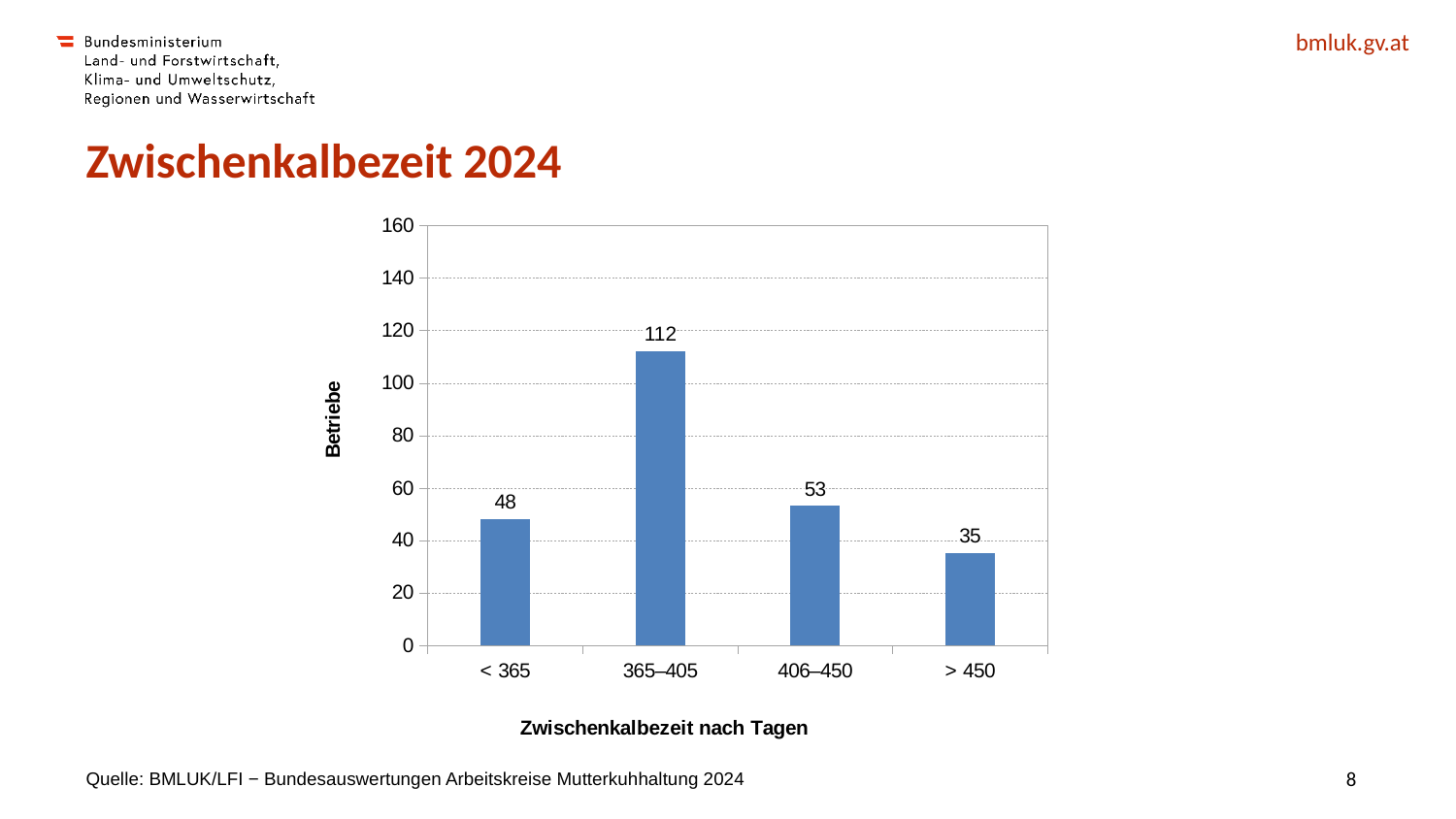
Which category has the lowest number of Betriebe? > 450 What is the label of the y axis? Betriebe What is the value for the < 365 category? 48 How many Betriebe are in the 365–405 category? 112 What is the difference between the 365–405 and 406–450 values? 59 Which is larger, the value for < 365 or the value for 406–450? 406–450 What is the label of the x axis? Zwischenkalbezeit nach Tagen Which category has the highest number of Betriebe? 365–405 What is the value for the > 450 category? 35 What kind of chart is shown on the slide? bar chart Is the value for 365–405 greater or less than 100? greater How many categories are shown on the x axis? 4